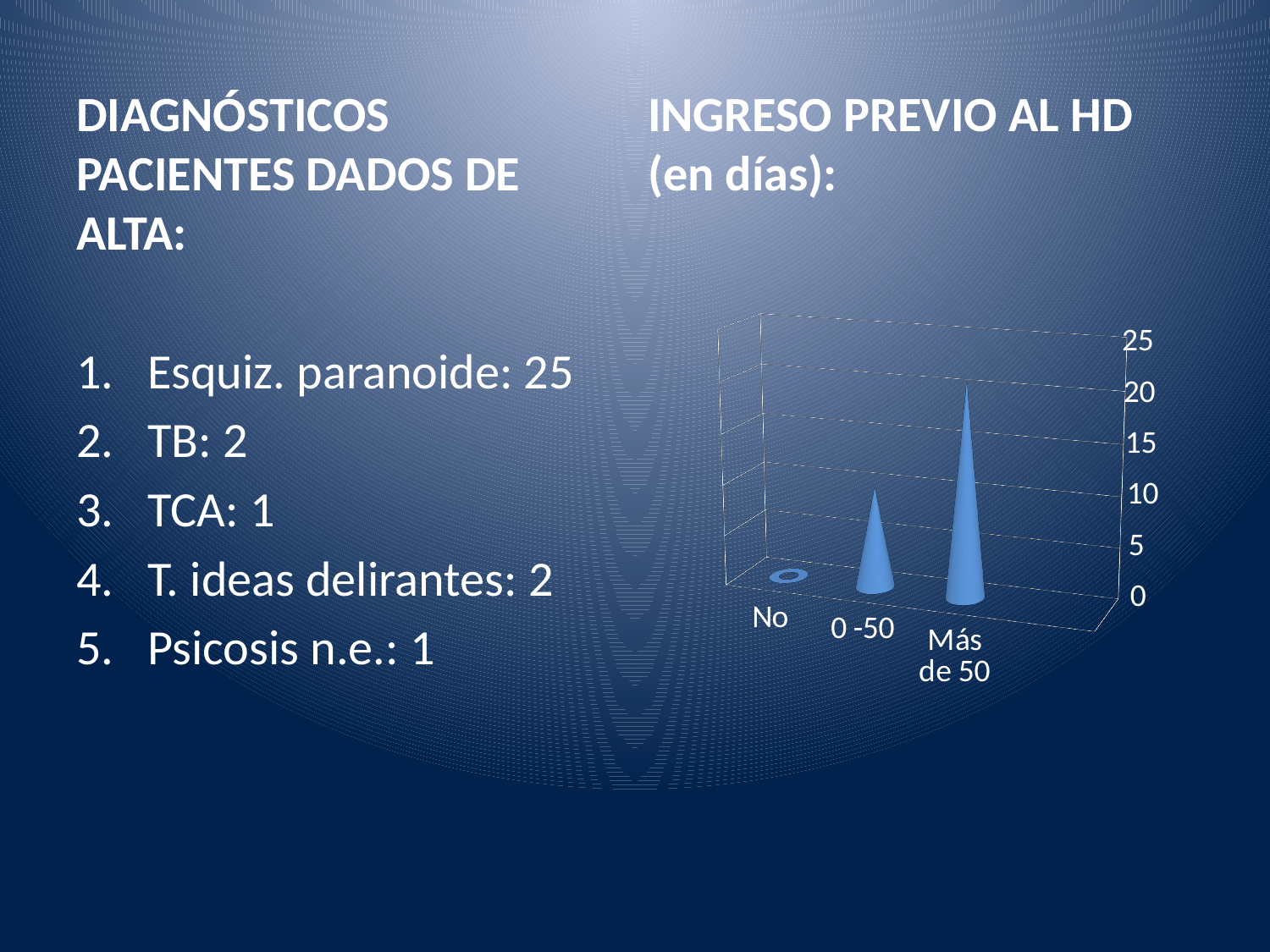
What kind of chart is shown on the slide? bar chart What is the title of the chart on the slide? INGRESO PREVIO AL HD (en días): Which category has the lowest value in the chart? No Is the value for "Más de 50" greater or less than 10? greater Which is larger, the value for "No" or the value for "0 -50"? 0 -50 Which is larger, the value for "0 -50" or the value for "Más de 50"? Más de 50 Is the value for "0 -50" greater or less than 5? greater Which category has the highest value in the chart? Más de 50 Is the value for "No" greater or less than 5? less Do the values rise or fall moving from "No" to "Más de 50" along the x axis? rise How many categories are shown on the chart's x axis? 3